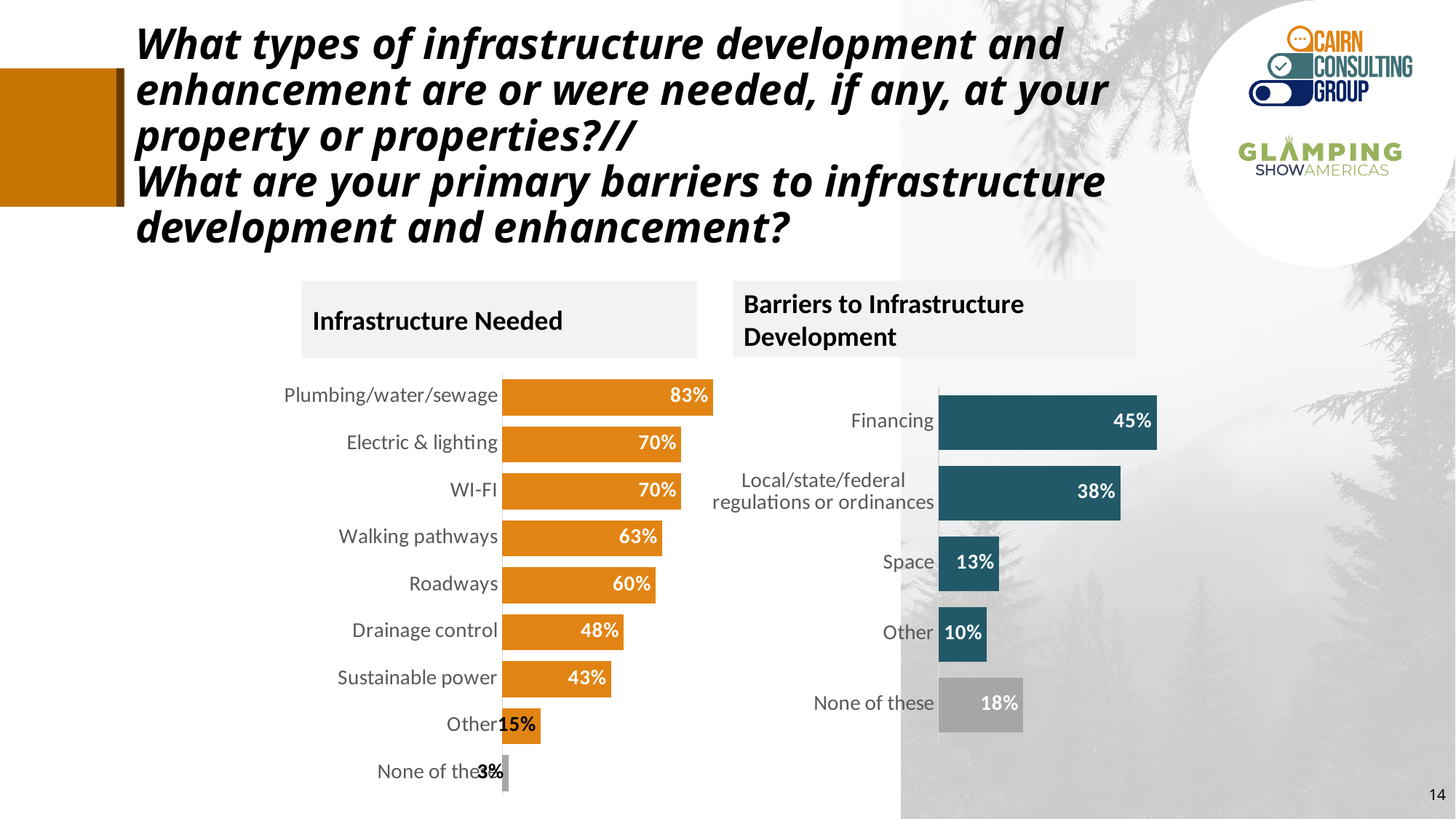
In the Infrastructure Needed chart, what is the value for Walking pathways? 63% In the Infrastructure Needed chart, which category has the highest value? Plumbing/water/sewage In the Infrastructure Needed chart, what is the difference between Roadways and Drainage control? 12% In the Barriers to Infrastructure Development chart, what is the value for Financing? 45% In the Infrastructure Needed chart, how many categories are shown? 9 In the Infrastructure Needed chart, which category has the lowest value? None of these In the Barriers to Infrastructure Development chart, what is the value for Local/state/federal regulations or ordinances? 38% In the Barriers to Infrastructure Development chart, how many categories are shown? 5 What type of chart is the Barriers to Infrastructure Development chart? Bar chart In the Barriers to Infrastructure Development chart, what is the difference between Financing and Other? 35% In the Infrastructure Needed chart, what is the value for Plumbing/water/sewage? 83% In the Barriers to Infrastructure Development chart, which is larger, Space or None of these? None of these